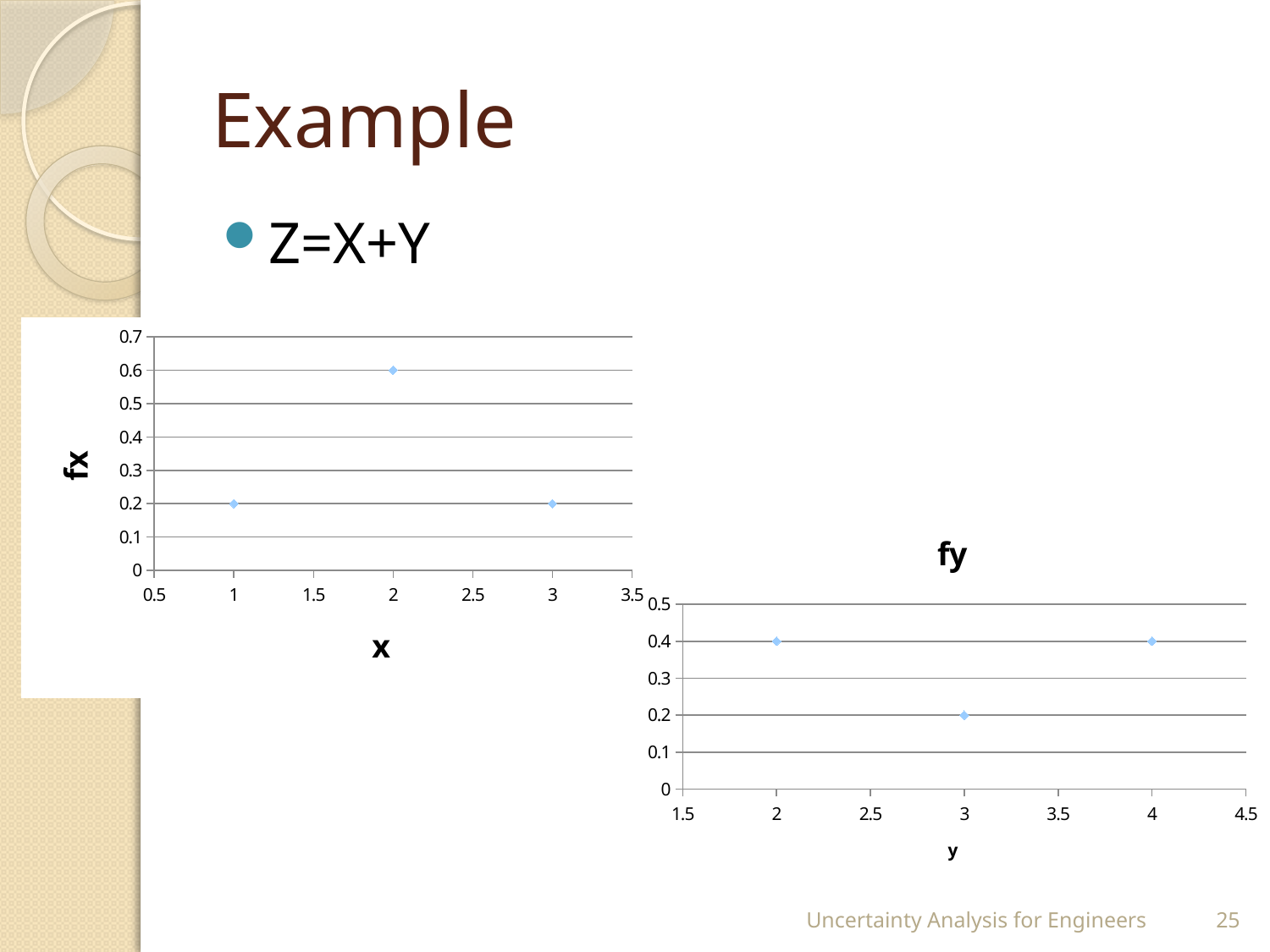
On the left chart (fx vs x), is the value of fx at x = 2 greater or less than 0.5? greater On the left chart (fx vs x), at which x value is fx highest? 2 On the left chart (fx vs x), how many data points are plotted? 3 On the chart titled fy, which is larger: fy at y = 2 or fy at y = 3? fy at y = 2 On the left chart (fx vs x), what is the difference between fx at x = 2 and fx at x = 3? 0.4 On the chart titled fy, what is the value of fy at y = 4? 0.4 On the chart titled fy, what is the value of fy at y = 3? 0.2 On the left chart (fx vs x), what is the value of fx at x = 1? 0.2 On the chart titled fy, how many data points are plotted? 3 On the left chart (fx vs x), what is the value of fx at x = 2? 0.6 What type of chart is the chart titled fy? Scatter chart On the chart titled fy, at which y value is fy lowest? 3